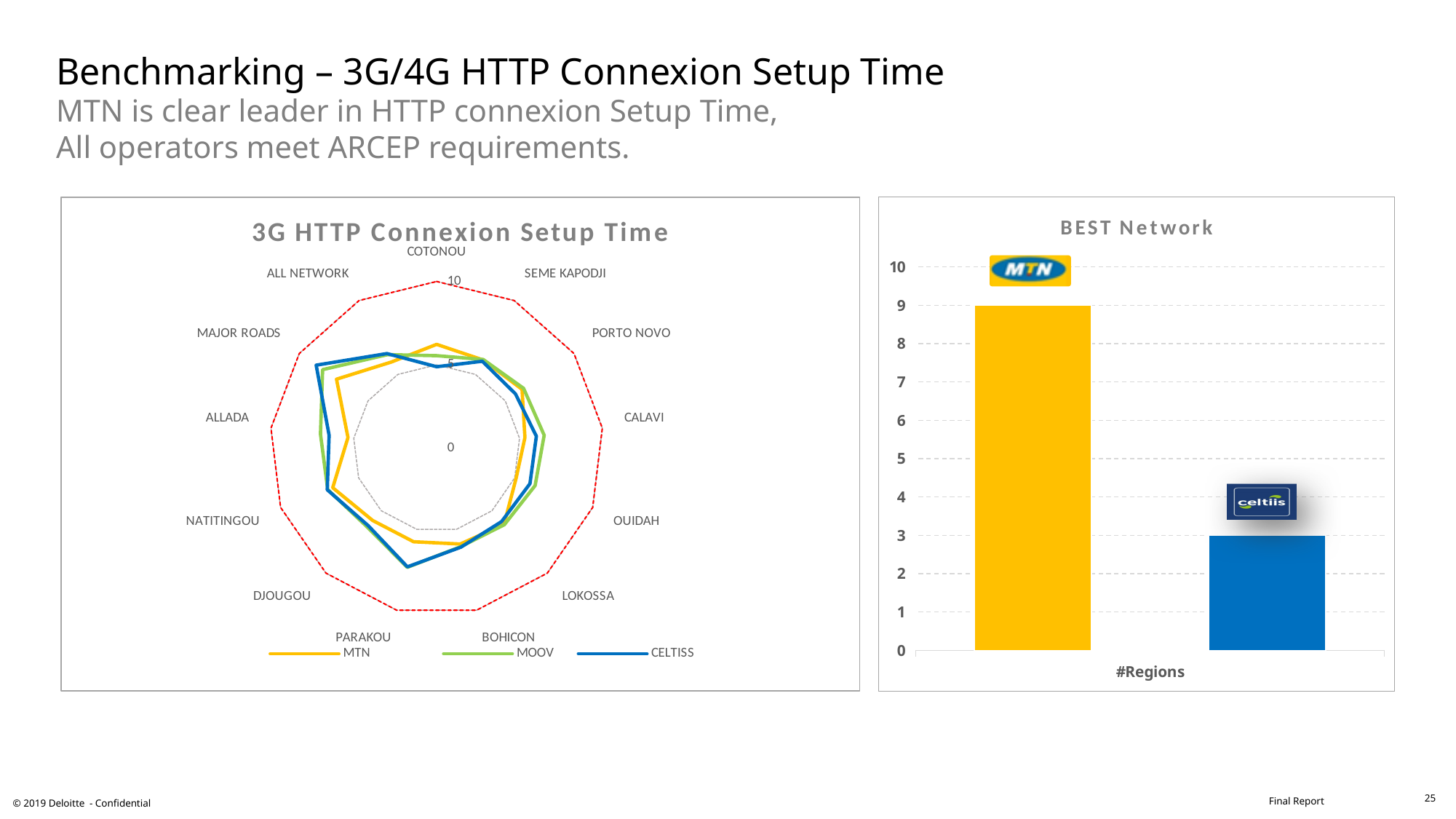
In the 'BEST Network' chart, what is the value for Celtiis? 3 What kind of chart is the 'BEST Network' chart on the right? Bar chart What is the x-axis label of the 'BEST Network' chart? #Regions In the 'BEST Network' chart, what is the value for MTN? 9 Which series are listed in the legend of the '3G HTTP Connexion Setup Time' chart? MTN, MOOV, CELTISS How many bars are plotted in the 'BEST Network' chart? 2 How many series does the legend of the '3G HTTP Connexion Setup Time' chart list? 3 In the 'BEST Network' chart, which operator has the higher value, MTN or Celtiis? MTN In the '3G HTTP Connexion Setup Time' chart, is the value for CELTISS at DJOUGOU greater or less than 5? greater How many categories are plotted around the '3G HTTP Connexion Setup Time' chart? 13 In the 'BEST Network' chart, what is the difference between the MTN and Celtiis values? 6 What kind of chart is the '3G HTTP Connexion Setup Time' chart? Radar chart